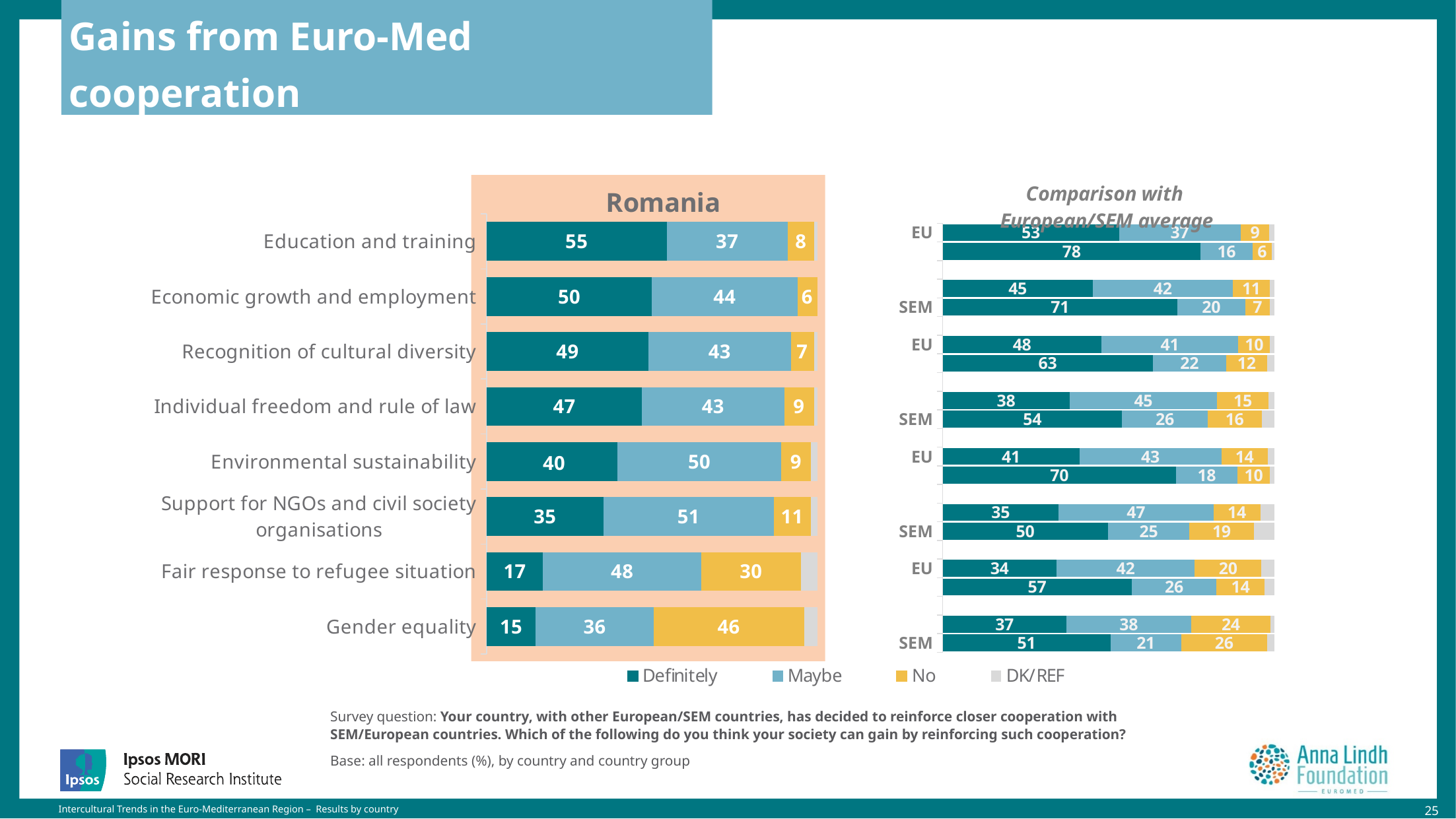
What kind of chart is the Romania chart? Stacked bar chart In the Romania chart, what is the 'No' value for Gender equality? 46 In the Romania chart, what is the 'Maybe' value for Support for NGOs and civil society organisations? 51 In the Comparison with European/SEM average chart, what is the EU 'No' value for the last (Gender equality) pair? 24 How many series does the legend list? 4 In the Romania chart, which is larger: the 'No' value for Fair response to refugee situation or the 'No' value for Gender equality? Gender equality In the Romania chart, which category has the highest 'Definitely' value? Education and training How many categories are shown in the Romania chart? 8 In the Romania chart, which category has the lowest 'Definitely' value? Gender equality In the Romania chart, what is the difference between the 'Definitely' values for Economic growth and employment and Fair response to refugee situation? 33 In the Romania chart, what percentage say their society can definitely gain in Education and training? 55 In the Comparison with European/SEM average chart, what is the SEM 'Definitely' value for the first (Education and training) pair? 78